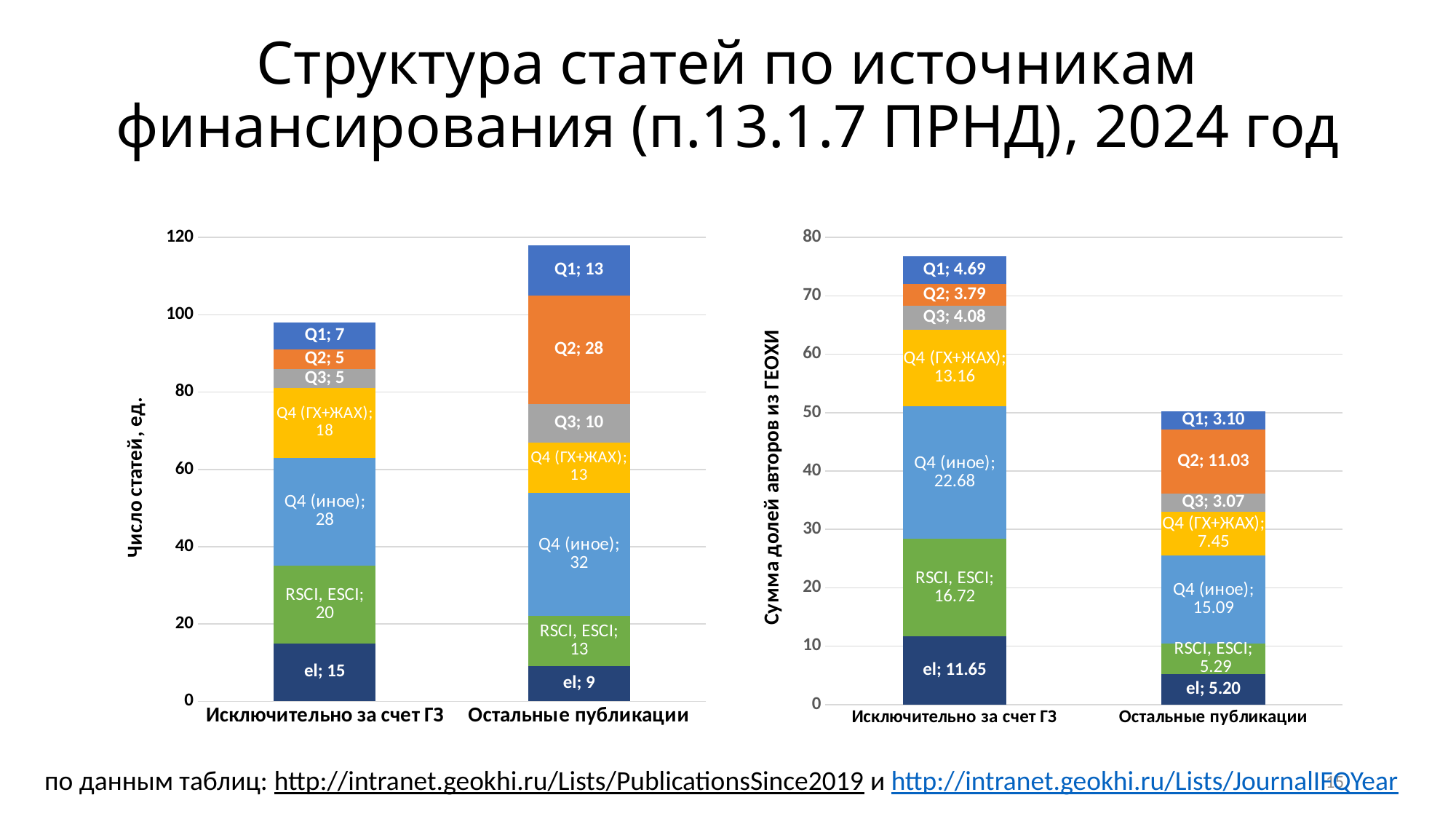
In the left chart (Число статей, ед.), what is the value of the el segment for Исключительно за счет ГЗ? 15 In the right chart (Сумма долей авторов из ГЕОХИ), what is the value of the Q1 segment for Остальные публикации? 3.10 In the left chart (Число статей, ед.), what is the value of the Q2 segment for Остальные публикации? 28 In the left chart (Число статей, ед.), what is the difference between the Q4 (иное) values for Остальные публикации and Исключительно за счет ГЗ? 4 In the right chart (Сумма долей авторов из ГЕОХИ), is the total of the Остальные публикации bar greater or less than 60? less What is the y-axis label of the left chart? Число статей, ед. In the left chart (Число статей, ед.), what is the total of the stacked bar for Исключительно за счет ГЗ? 98 In the left chart (Число статей, ед.), what is the total of the stacked bar for Остальные публикации? 118 How many categories are shown on the x axis of the left chart (Число статей, ед.)? 2 What type of chart is the right chart (Сумма долей авторов из ГЕОХИ)? stacked bar chart In the right chart (Сумма долей авторов из ГЕОХИ), what is the value of the Q4 (иное) segment for Исключительно за счет ГЗ? 22.68 In the right chart (Сумма долей авторов из ГЕОХИ), which category has the larger Q2 value, Исключительно за счет ГЗ or Остальные публикации? Остальные публикации